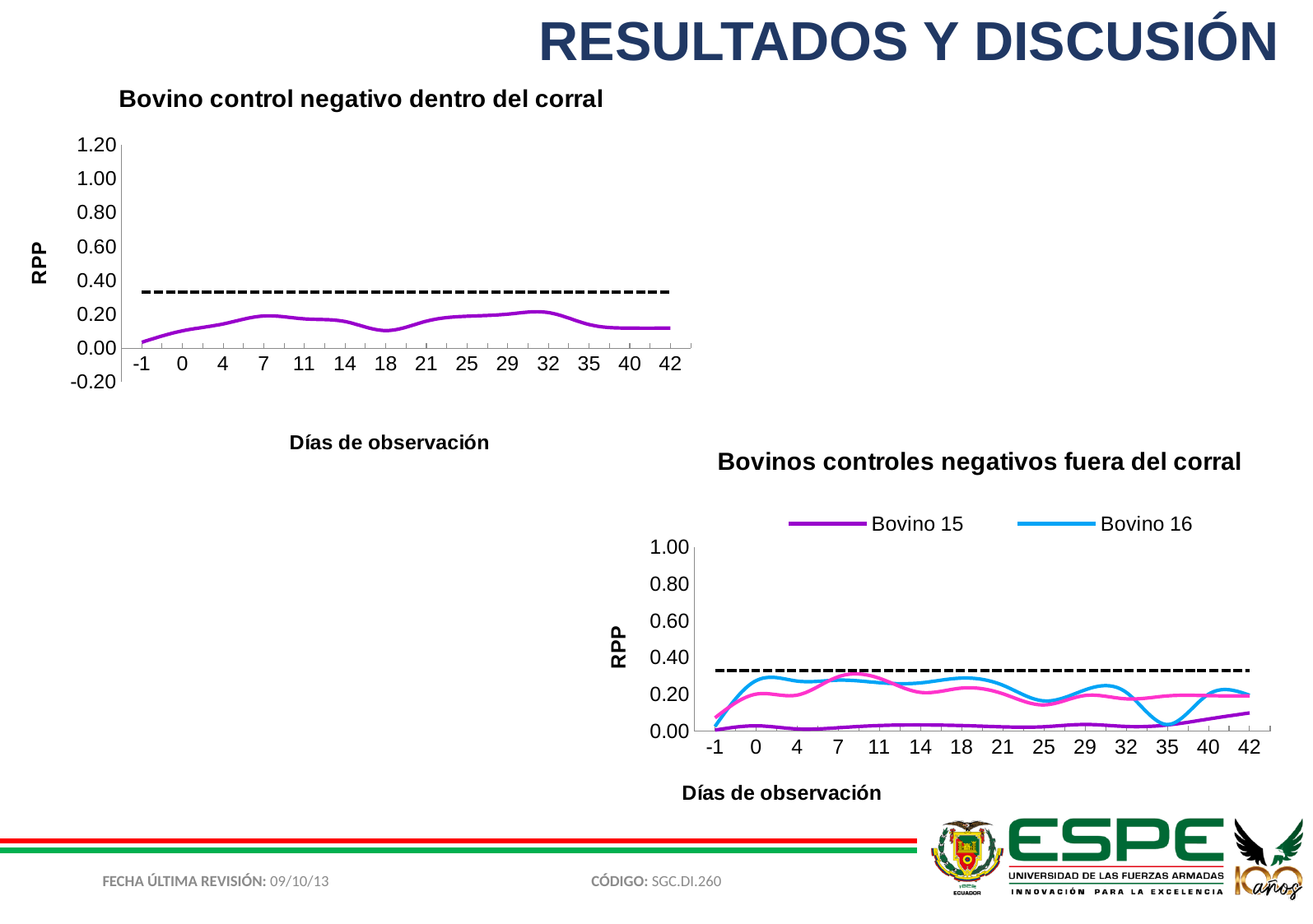
What is the x-axis title of the chart 'Bovino control negativo dentro del corral'? Días de observación In the chart 'Bovino control negativo dentro del corral', does the RPP value rise or fall from day -1 to day 7? rise What kind of chart is 'Bovino control negativo dentro del corral'? line chart In the chart 'Bovinos controles negativos fuera del corral', is the RPP value for Bovino 16 at day 35 greater or less than 0.20? less In the chart 'Bovino control negativo dentro del corral', is the RPP value at day 18 greater or less than 0.20? less How many series does the legend list in the chart 'Bovinos controles negativos fuera del corral'? 2 In the chart 'Bovino control negativo dentro del corral', is the RPP value at day 32 greater or less than 0.40? less In the chart 'Bovinos controles negativos fuera del corral', does the RPP value for Bovino 16 rise or fall from day 29 to day 35? fall In the chart 'Bovino control negativo dentro del corral', how many observation days are marked on the x axis? 14 In the chart 'Bovinos controles negativos fuera del corral', at day 0, which has the higher RPP value, Bovino 15 or Bovino 16? Bovino 16 What are the legend entries in the chart 'Bovinos controles negativos fuera del corral'? Bovino 15, Bovino 16